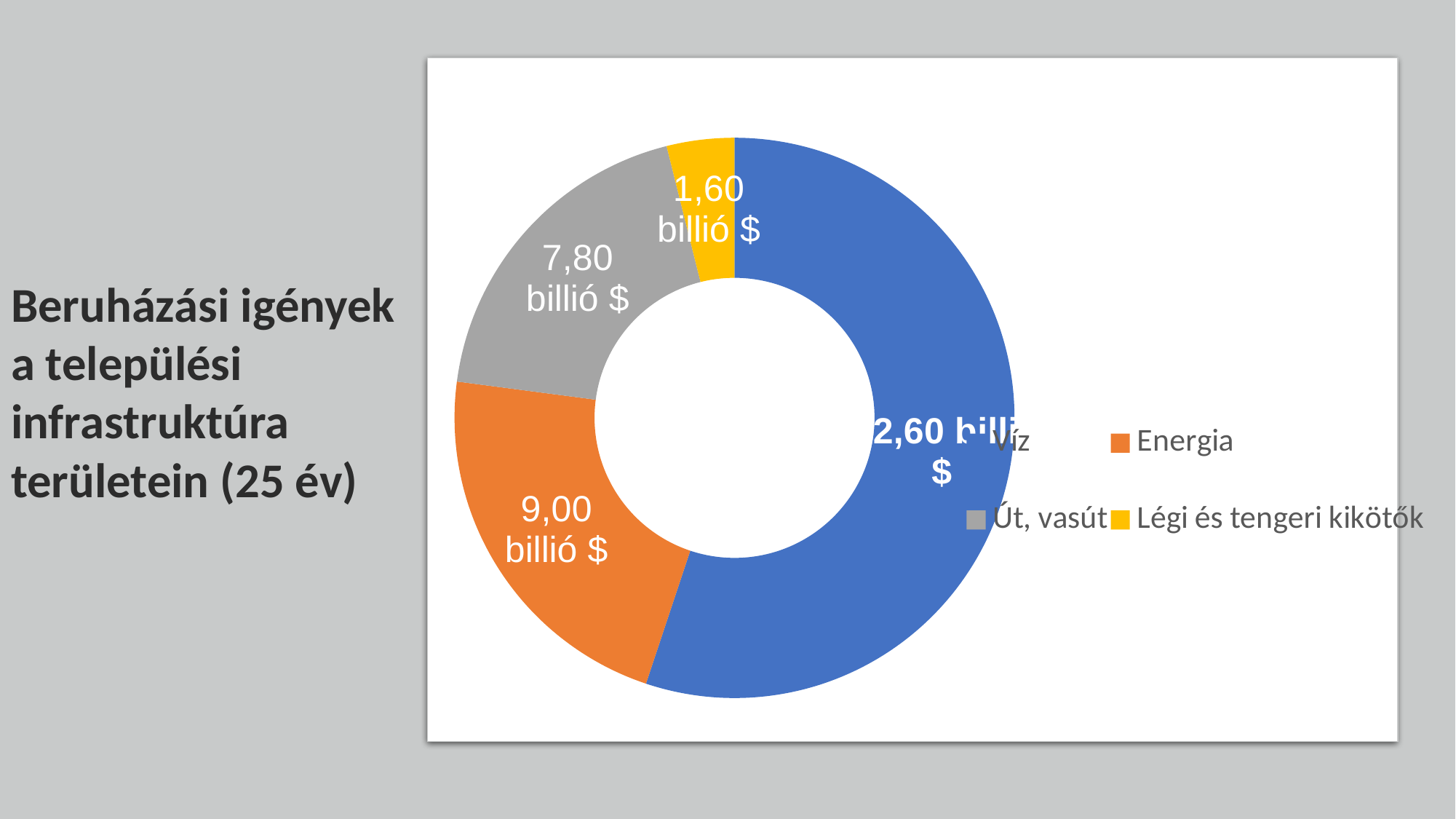
What is the value shown for Energia? 9,00 billió $ What kind of chart is shown on the slide? Doughnut (pie) chart What colour is the Energia slice? Orange Which is larger, the value for Energia or the value for Út, vasút? Energia What is the title text on the left of the slide? Beruházási igények a települési infrastruktúra területein (25 év) Which category has the smallest slice of the chart? Légi és tengeri kikötők Which category has the largest slice of the chart? Víz What is the value shown for Út, vasút? 7,80 billió $ What is the value shown for Légi és tengeri kikötők? 1,60 billió $ What is the difference between the values for Energia and Légi és tengeri kikötők? 7,40 billió $ What is the difference between the values for Energia and Út, vasút? 1,20 billió $ How many categories are shown in the chart? 4